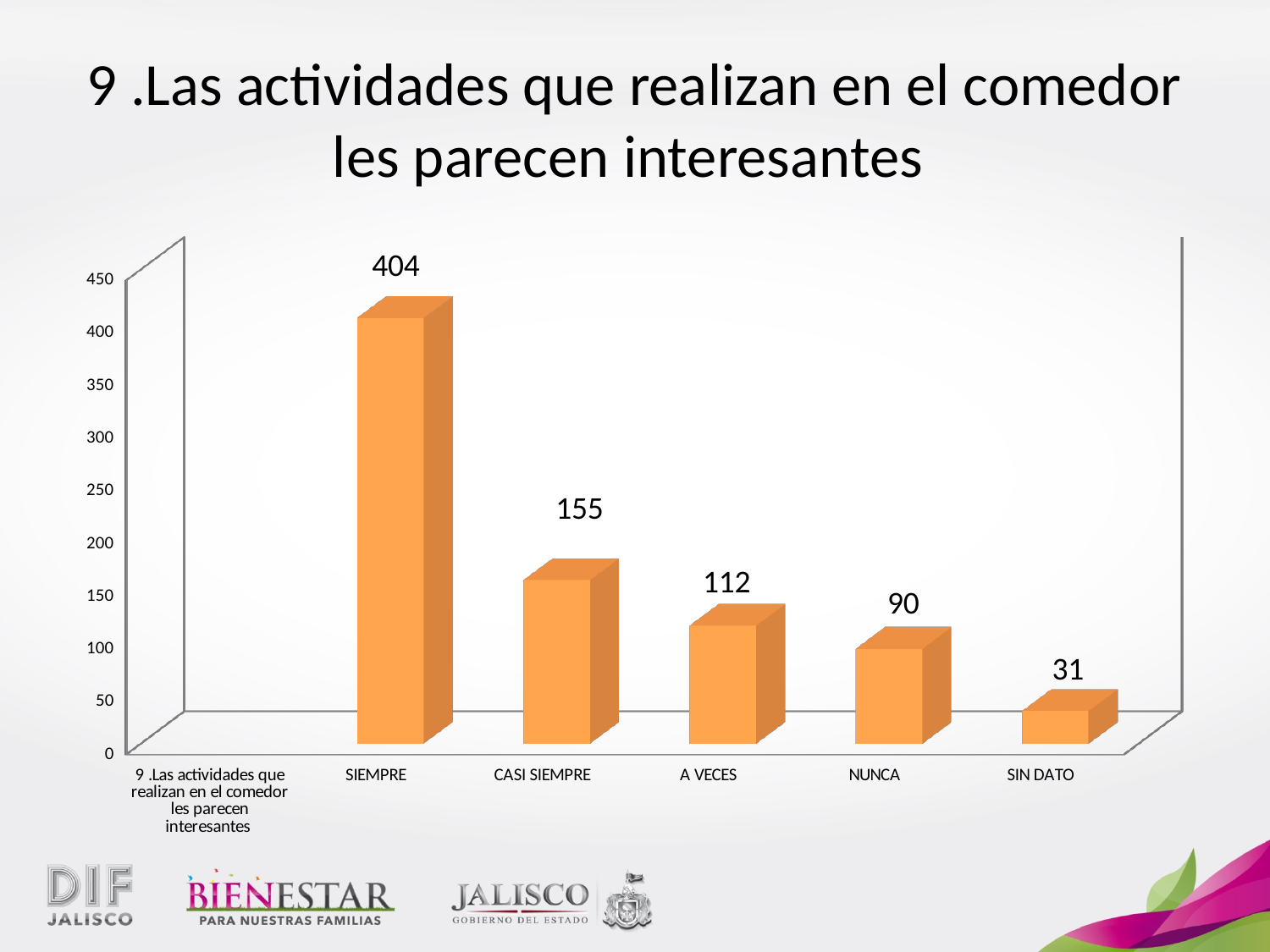
What is the value for NUNCA? 90 What is the value for CASI SIEMPRE? 155 How many bars are plotted in the chart? 5 What is the value for SIN DATO? 31 What kind of chart is shown on the slide? bar chart What is the difference between the values for SIEMPRE and CASI SIEMPRE? 249 Which is larger, the value for A VECES or the value for NUNCA? A VECES What is the value for A VECES? 112 What is the value for SIEMPRE? 404 Which category has the highest value? SIEMPRE Is the value for CASI SIEMPRE greater or less than 200? less Which category has the lowest value? SIN DATO